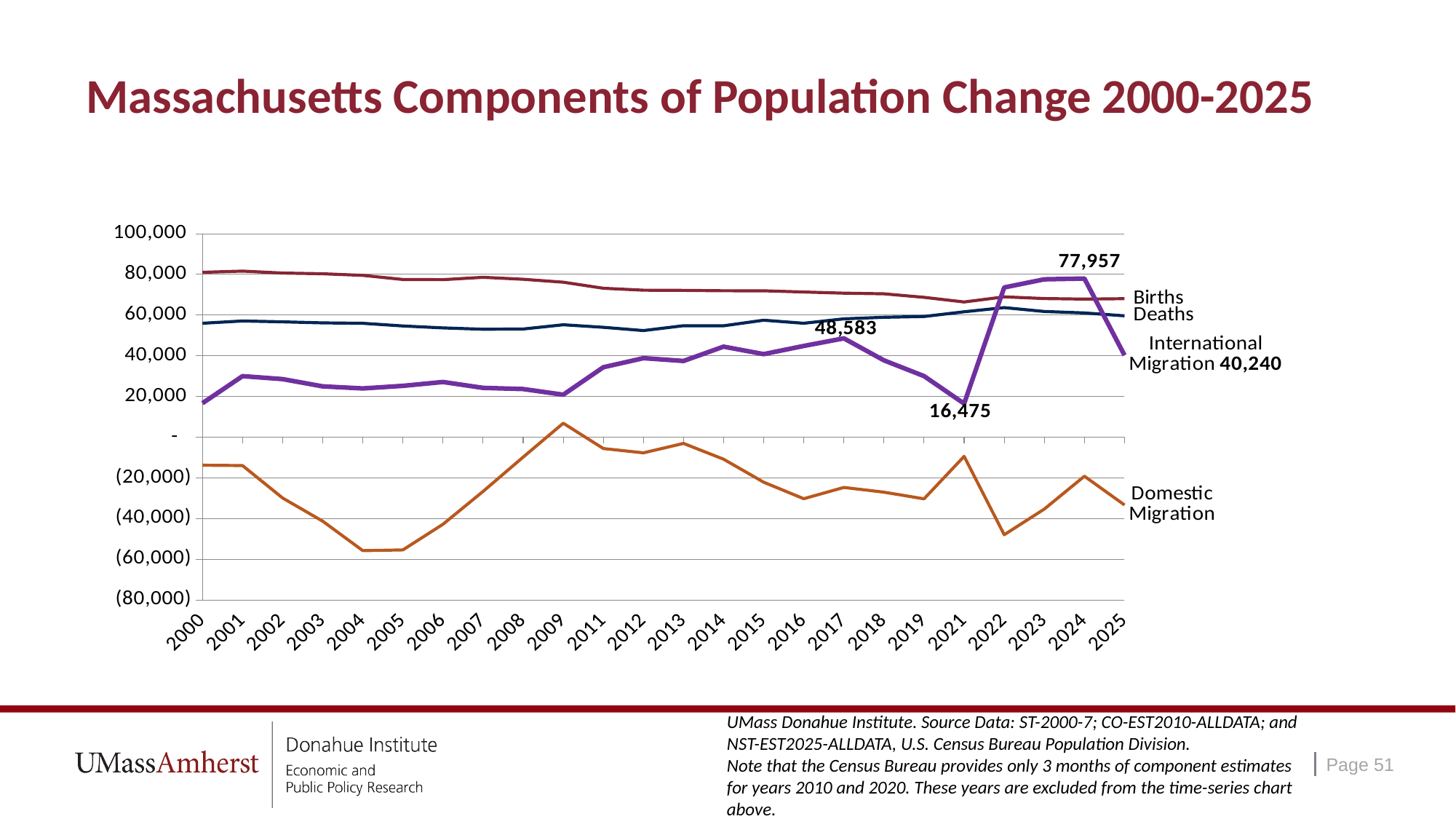
Which year shows the highest labeled value for International Migration? 2024 What was International Migration in 2024? 77,957 Is the value for Domestic Migration in 2004 greater or less than (40,000)? less What type of chart is shown on the slide? line chart What was International Migration in 2025? 40,240 What was International Migration in 2017? 48,583 What is the title of the chart? Massachusetts Components of Population Change 2000-2025 Is the value for Births in 2000 greater or less than 60,000? greater How much higher was International Migration in 2024 than in 2021? 61,482 Which series is higher in 2025, Births or Deaths? Births Which year shows the lowest labeled value for International Migration? 2021 What was International Migration in 2021? 16,475